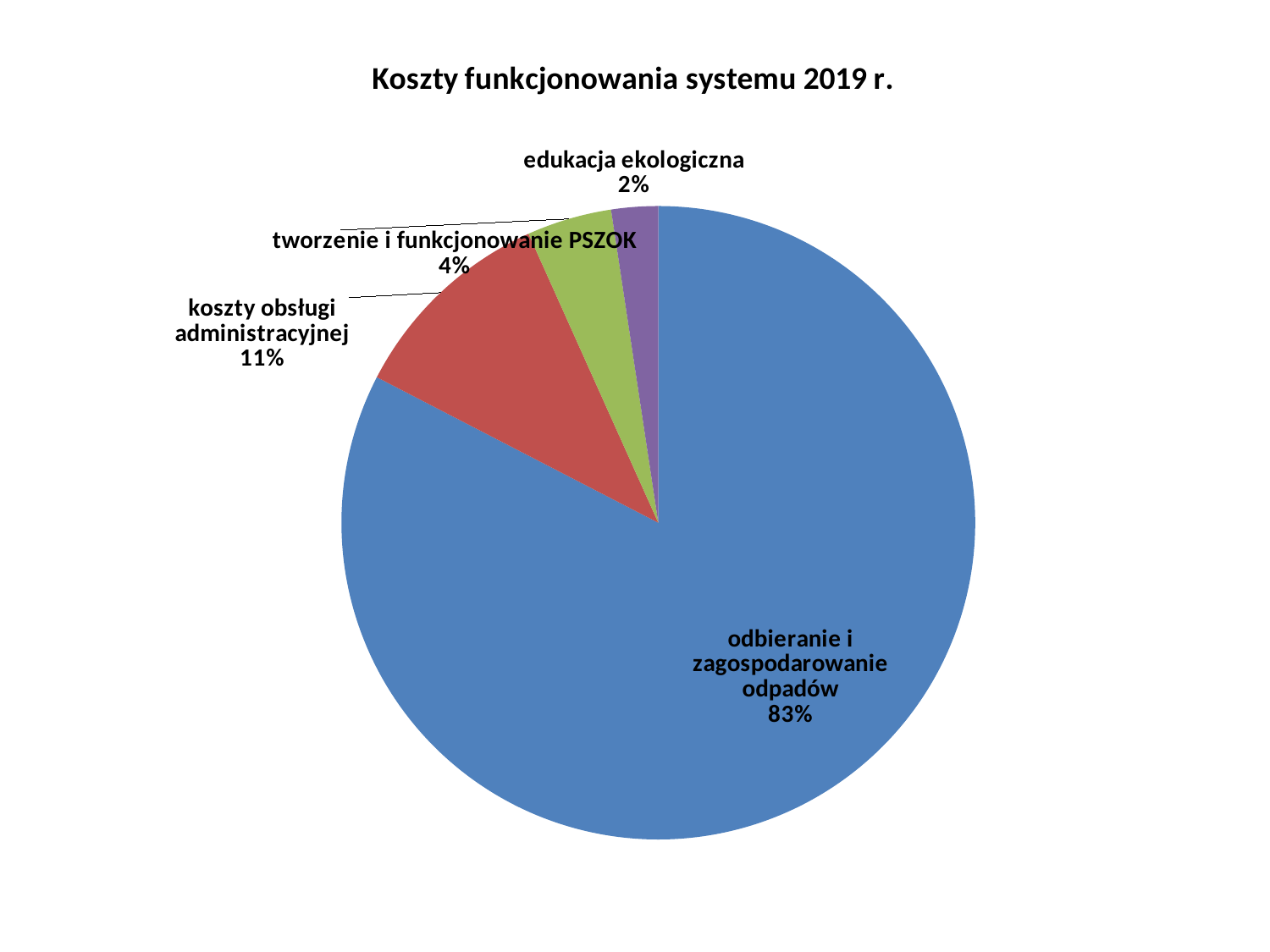
What is the title of the chart? Koszty funkcjonowania systemu 2019 r. What share of the pie is 'edukacja ekologiczna'? 2% What colour is the slice for 'koszty obsługi administracyjnej'? red What share of the pie is 'tworzenie i funkcjonowanie PSZOK'? 4% Which is larger: the share for 'tworzenie i funkcjonowanie PSZOK' or the share for 'edukacja ekologiczna'? tworzenie i funkcjonowanie PSZOK What share of the pie is 'koszty obsługi administracyjnej'? 11% How many slices does the pie chart have? 4 What kind of chart is shown on the slide? pie chart What is the difference in percentage points between 'koszty obsługi administracyjnej' and 'tworzenie i funkcjonowanie PSZOK'? 7 percentage points Which category has the smallest share of the pie? edukacja ekologiczna Which category has the largest share of the pie? odbieranie i zagospodarowanie odpadów